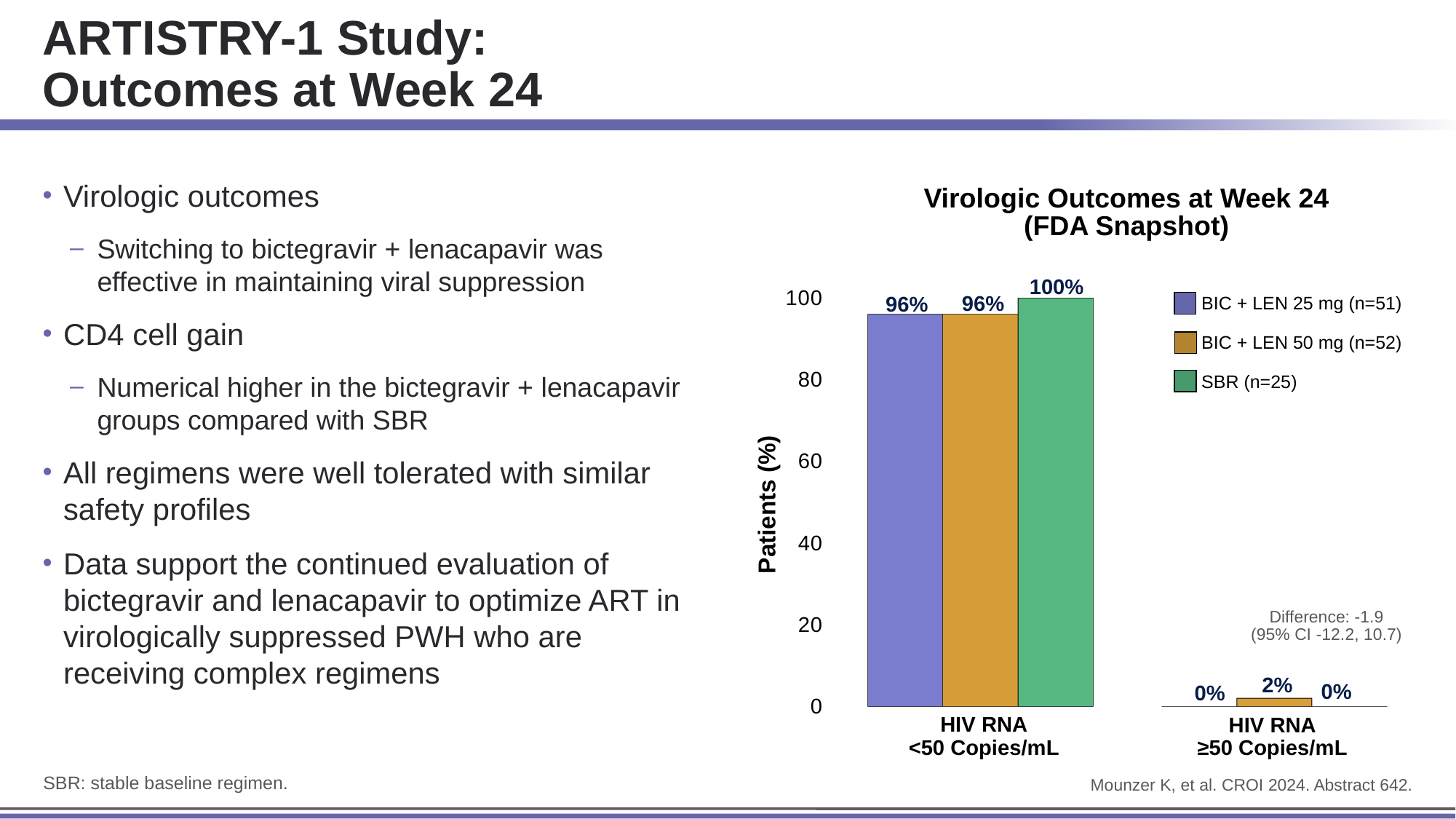
How many categories are shown on the x axis? 2 What is the difference in percentage points between the SBR group and the BIC + LEN 25 mg group for HIV RNA <50 copies/mL? 4 What is the title of the chart? Virologic Outcomes at Week 24 (FDA Snapshot) What kind of chart is shown on the slide? Bar chart What is the label of the y axis? Patients (%) What percentage of patients in the BIC + LEN 50 mg (n=52) group had HIV RNA ≥50 copies/mL? 2% How many series does the legend list? 3 What percentage of patients in the SBR (n=25) group had HIV RNA <50 copies/mL? 100% Which group had the highest percentage of patients with HIV RNA <50 copies/mL? SBR (n=25) Which group had the highest percentage of patients with HIV RNA ≥50 copies/mL? BIC + LEN 50 mg (n=52) What percentage of patients in the BIC + LEN 25 mg (n=51) group had HIV RNA <50 copies/mL? 96% Is the value for the BIC + LEN 50 mg group with HIV RNA <50 copies/mL greater or less than 80? greater